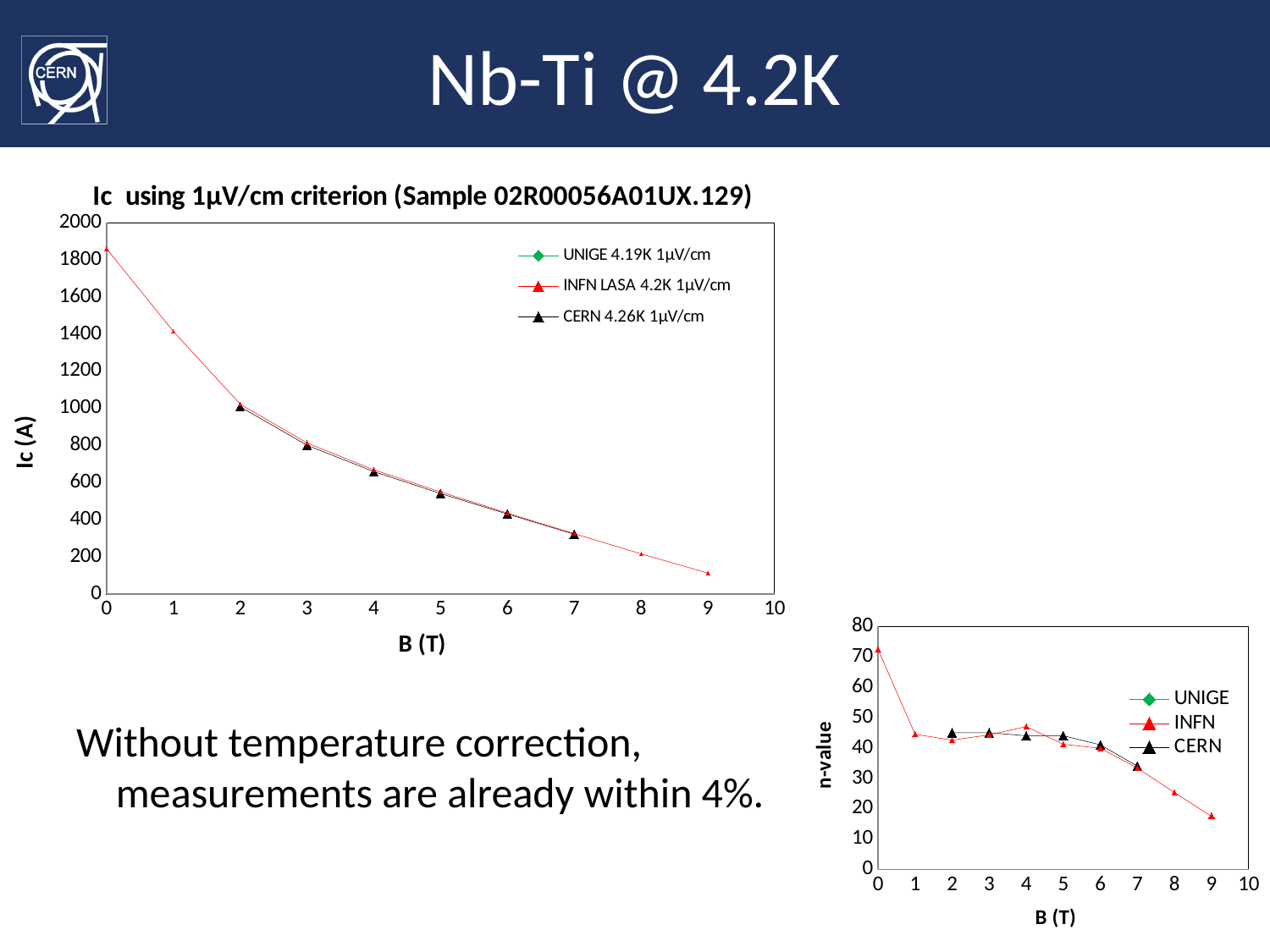
In the chart titled "Ic using 1μV/cm criterion (Sample 02R00056A01UX.129)", is the INFN LASA 4.2K 1μV/cm value at B = 1 T greater or less than 1200? greater In the chart titled "Ic using 1μV/cm criterion (Sample 02R00056A01UX.129)", which series is plotted with black triangle markers? CERN 4.26K 1μV/cm In the chart titled "Ic using 1μV/cm criterion (Sample 02R00056A01UX.129)", what kind of chart is shown? line chart In the chart titled "Ic using 1μV/cm criterion (Sample 02R00056A01UX.129)", what is the label of the y axis? Ic (A) In the chart titled "Ic using 1μV/cm criterion (Sample 02R00056A01UX.129)", does Ic rise or fall as B increases? fall In the chart titled "Ic using 1μV/cm criterion (Sample 02R00056A01UX.129)", is the INFN LASA 4.2K 1μV/cm value at B = 9 T greater or less than 200? less In the n-value chart at the bottom right, at which B (T) value is the INFN n-value highest? 0 In the n-value chart at the bottom right, is the INFN n-value at B = 9 T greater or less than 20? less In the chart titled "Ic using 1μV/cm criterion (Sample 02R00056A01UX.129)", how many series does the legend list? 3 In the n-value chart at the bottom right, how many series does the legend list? 3